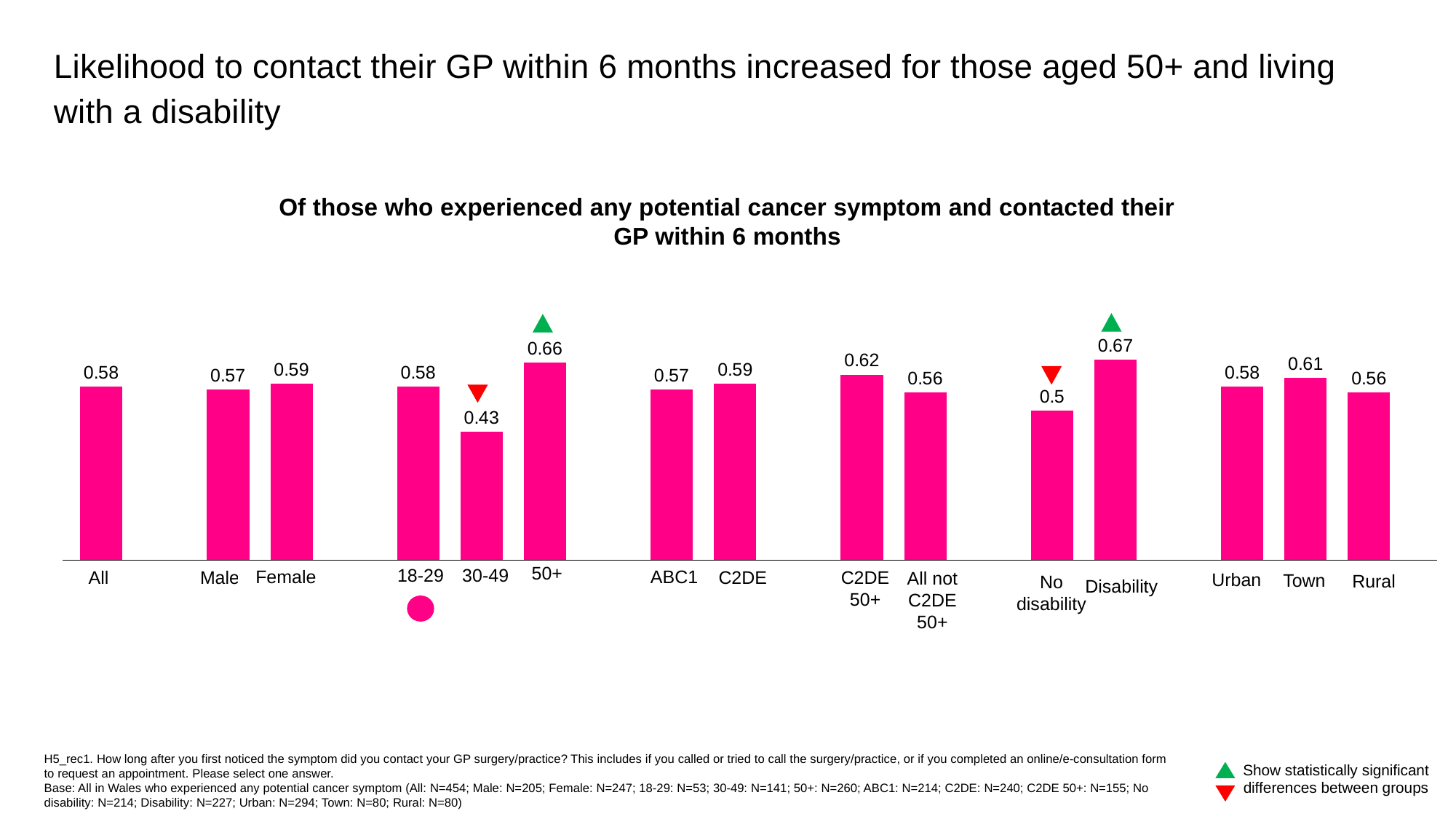
What is the value for the 30-49 age group? 0.43 What kind of chart is shown on the slide? Bar chart What is the value for the All group? 0.58 What is the value for the Disability group? 0.67 Which group has the highest value? Disability What is the difference between the values for Disability and No disability? 0.17 How many bars are plotted in the chart? 15 What is the difference between the values for 50+ and 30-49? 0.23 What is the value for Town? 0.61 What is the title of the chart? Of those who experienced any potential cancer symptom and contacted their GP within 6 months Which group has the lowest value? 30-49 Which is larger, the value for C2DE 50+ or the value for All not C2DE 50+? C2DE 50+